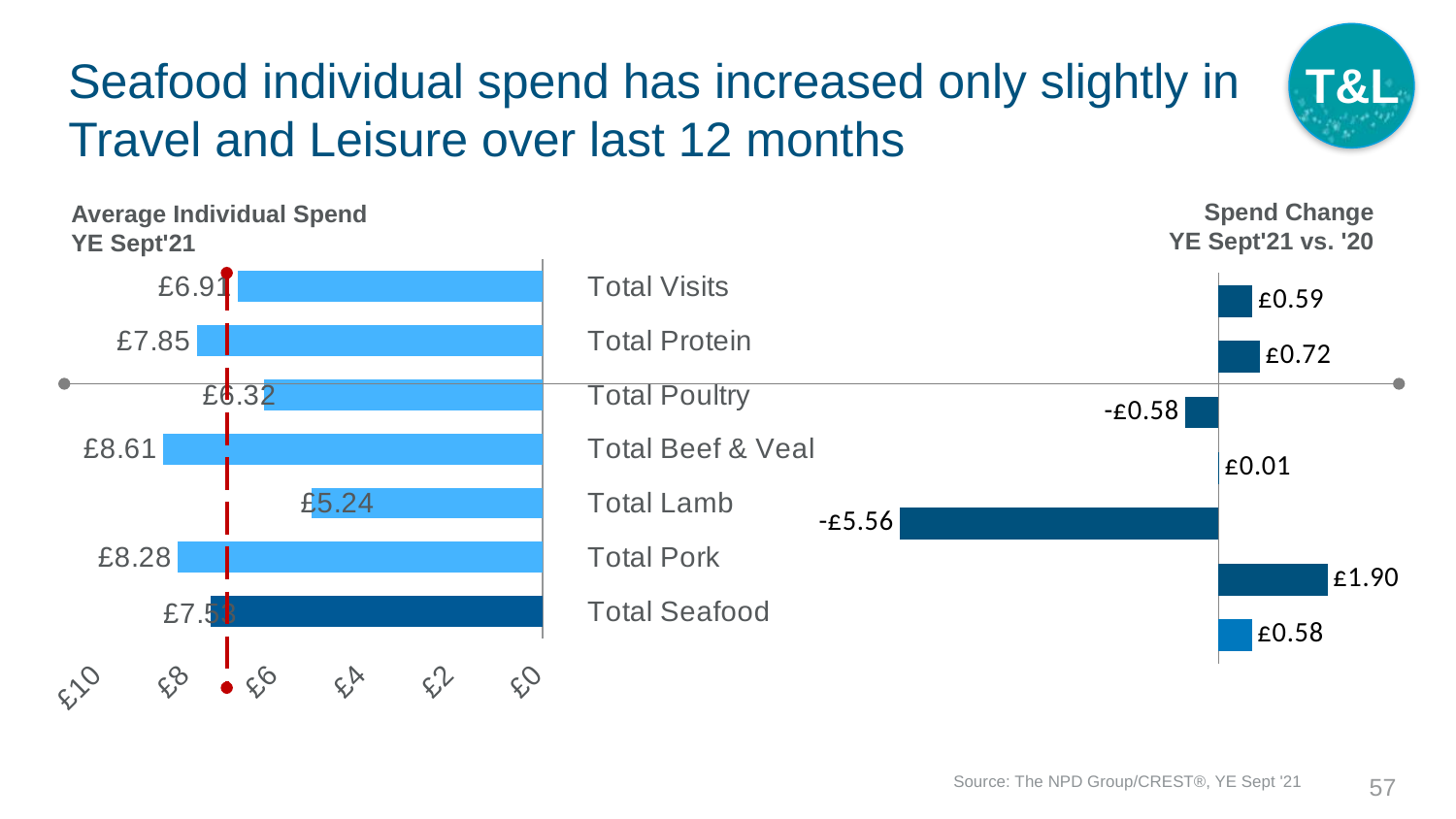
In the Spend Change YE Sept'21 vs. '20 chart, what is the value for Total Pork? £1.90 In the Spend Change YE Sept'21 vs. '20 chart, which category has the largest increase? Total Pork In the Average Individual Spend YE Sept'21 chart, what is the difference between Total Pork and Total Lamb? £3.04 How many categories are shown in the Average Individual Spend YE Sept'21 chart? 7 What type of chart is the Spend Change YE Sept'21 vs. '20 chart? Bar chart In the Spend Change YE Sept'21 vs. '20 chart, which is larger: Total Protein or Total Visits? Total Protein In the Average Individual Spend YE Sept'21 chart, which category has the highest value? Total Beef & Veal In the Spend Change YE Sept'21 vs. '20 chart, what is the value for Total Lamb? -£5.56 In the Spend Change YE Sept'21 vs. '20 chart, which category has the lowest value? Total Lamb In the Average Individual Spend YE Sept'21 chart, what is the value for Total Beef & Veal? £8.61 In the Average Individual Spend YE Sept'21 chart, which category has the lowest value? Total Lamb In the Spend Change YE Sept'21 vs. '20 chart, what is the value for Total Poultry? -£0.58